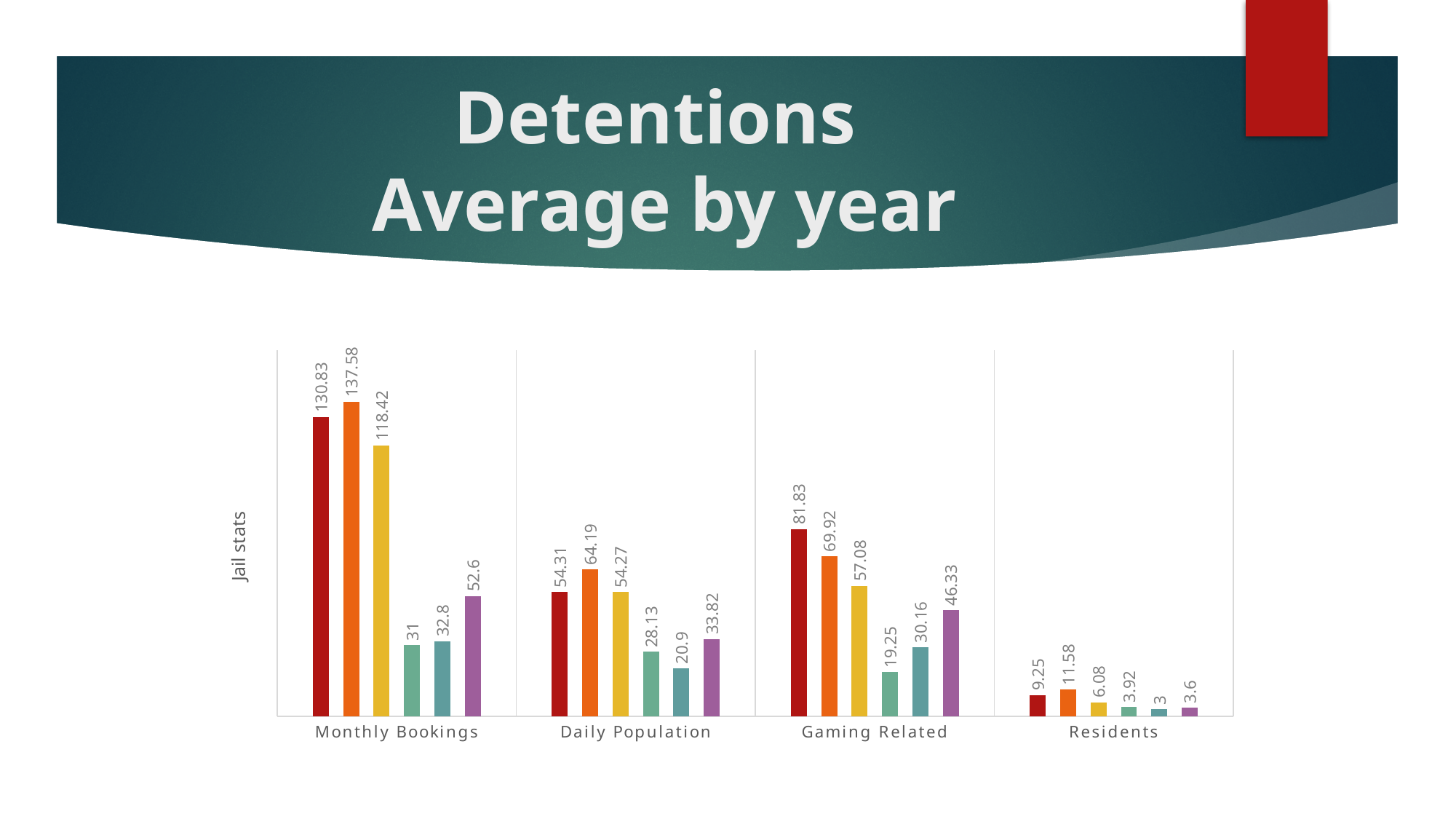
What is the difference between the orange bar and the dark red bar in the Monthly Bookings group? 6.75 What is the value of the yellow bar in the Daily Population group? 54.27 What is the value of the teal bar in the Residents group? 3 Which bar is the shortest in the Daily Population group? the teal bar (20.9) What kind of chart is shown on the slide? bar chart What is the label on the vertical axis of the chart? Jail stats How many categories are shown along the x axis of the chart? 4 Which is larger in the Residents group, the orange bar or the dark red bar? the orange bar (11.58) Which bar is the tallest in the Gaming Related group? the dark red bar (81.83) What is the value of the orange bar in the Monthly Bookings group? 137.58 How many bars are plotted in each category group? 6 What is the value of the purple bar in the Gaming Related group? 46.33